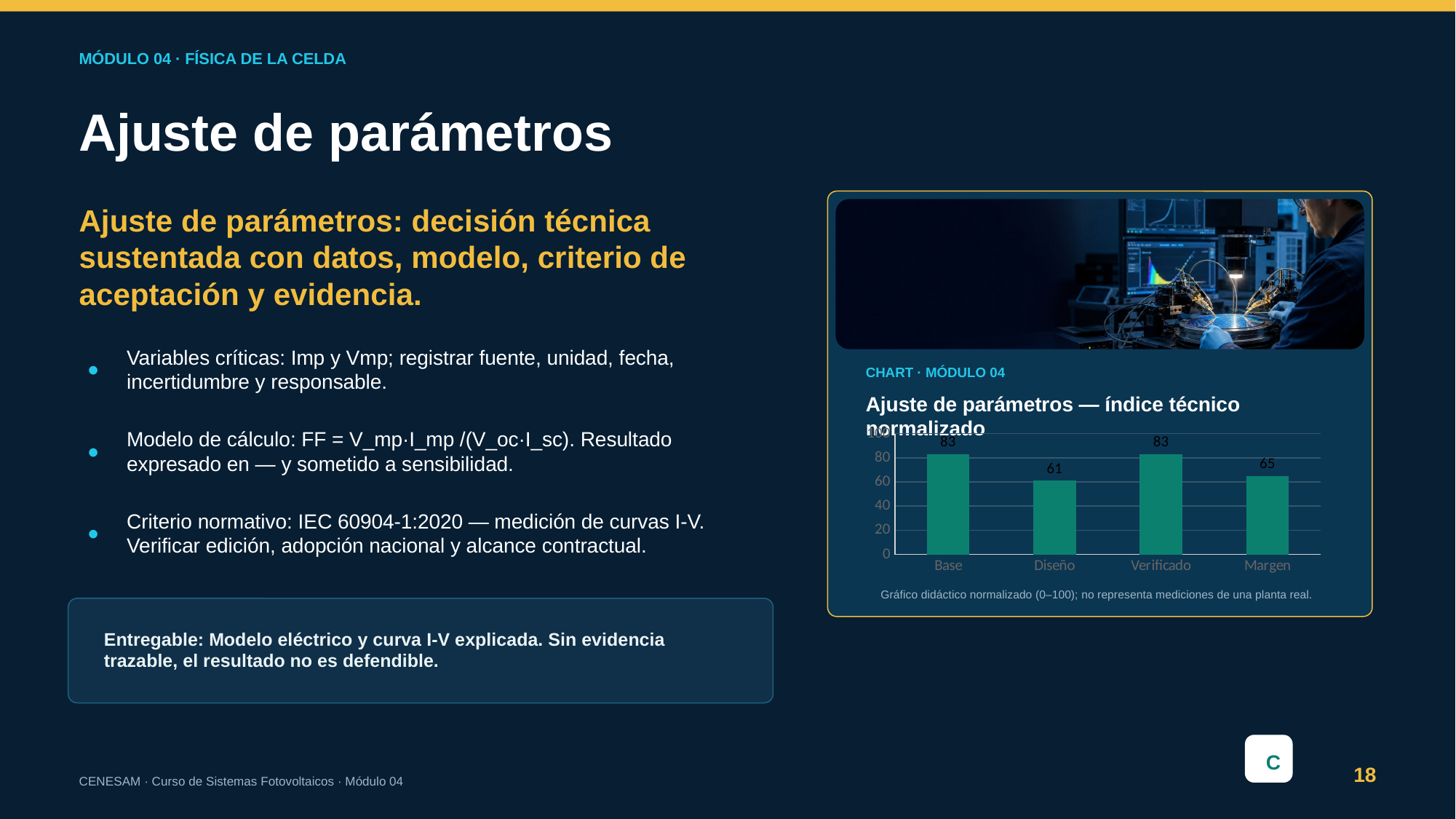
How many categories are shown on the x axis? 4 Which is larger, the value for Verificado or the value for Margen? Verificado What kind of chart is shown on the slide? bar chart What is the difference between the values for Base and Diseño? 22 What is the value for Base? 83 Which category has the lowest value? Diseño What is the value for Verificado? 83 Is the value for Diseño greater or less than 80? less What is the value for Margen? 65 What is the difference between the values for Margen and Diseño? 4 What is the value for Diseño? 61 What is the title of the chart? Ajuste de parámetros — índice técnico normalizado